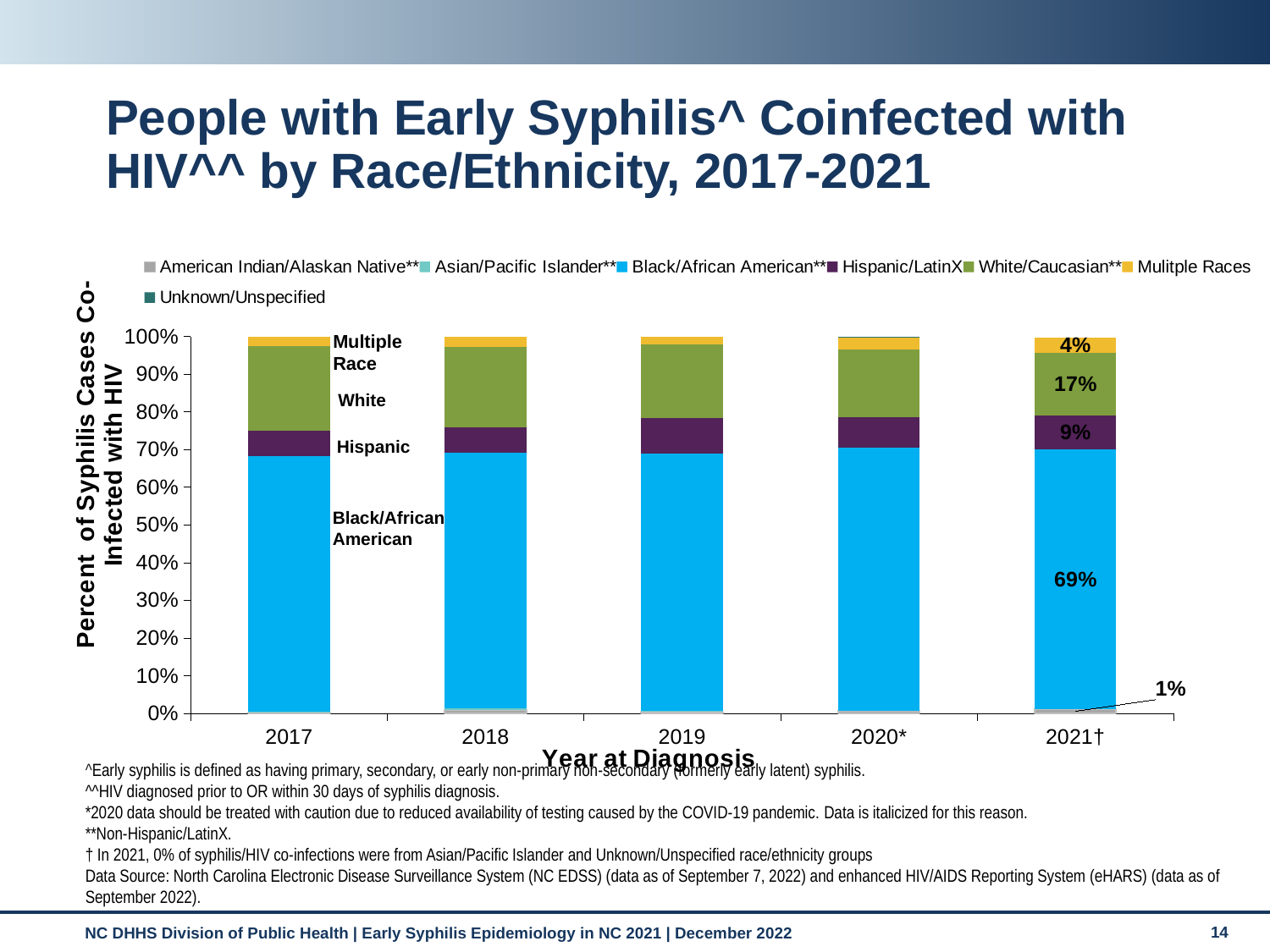
What is the title of the x axis of the chart? Year at Diagnosis In 2021, which share was larger: White/Caucasian or Hispanic/LatinX? White/Caucasian What kind of chart is shown on the slide? Stacked bar chart How many years are shown on the x axis of the chart? 5 What percentage of syphilis/HIV co-infections in 2021 were among people of Multiple Races? 4% How many race/ethnicity series does the legend list? 7 In 2021, how many percentage points higher was the Black/African American share than the White/Caucasian share? 52 percentage points What percentage of syphilis/HIV co-infections in 2021 were among White/Caucasian people? 17% Is the Black/African American share in 2017 greater or less than 60%? greater What percentage of syphilis/HIV co-infections in 2021 were among Black/African American people? 69% Which race/ethnicity group had the largest share of syphilis/HIV co-infections in 2021? Black/African American What percentage of syphilis/HIV co-infections in 2021 were among Hispanic/LatinX people? 9%